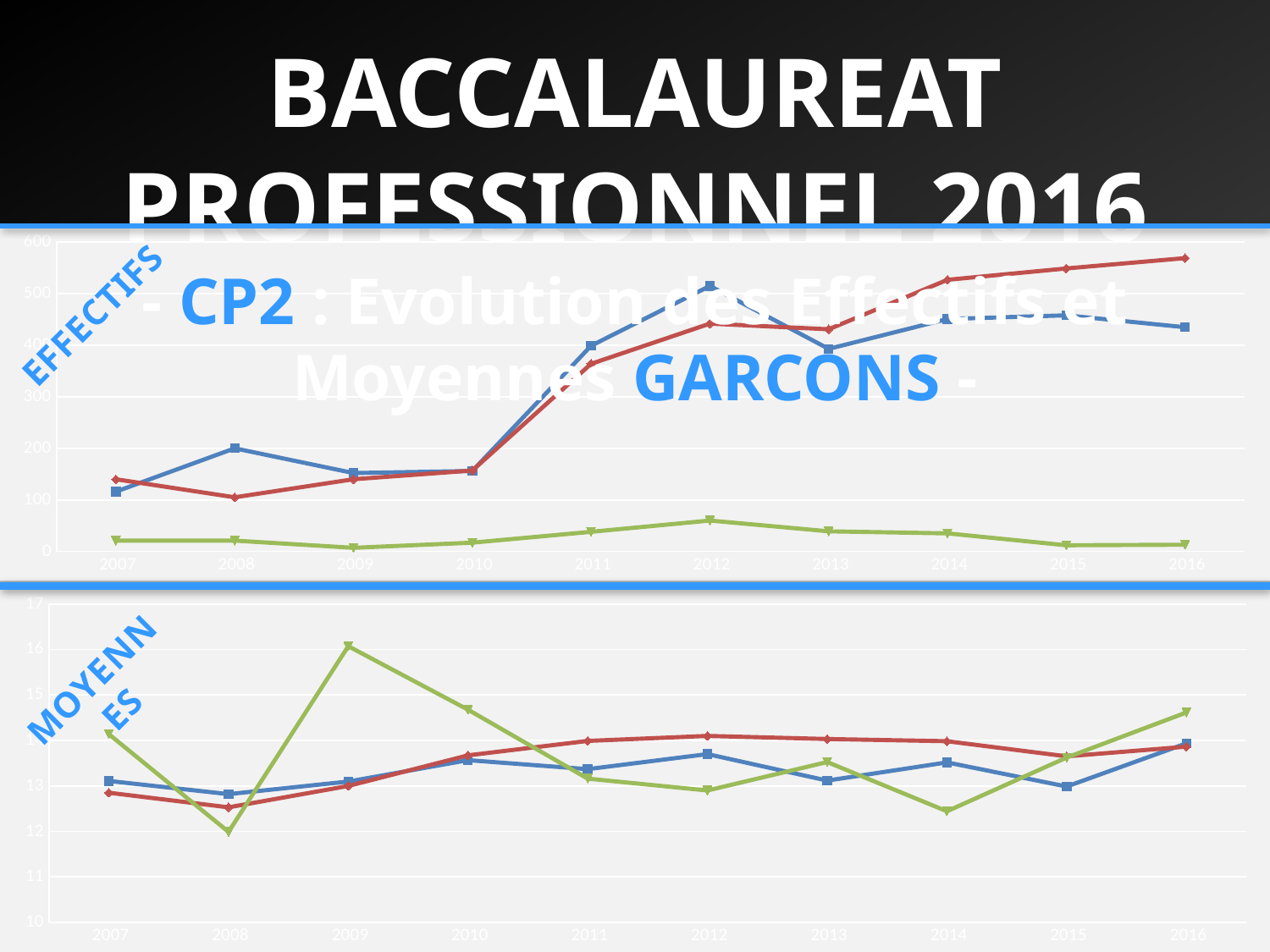
How many lines are plotted on the bottom chart (MOYENNES)? 3 In the bottom chart (MOYENNES), is the value of the green line in 2009 greater or less than 15? greater What kind of chart is the top chart (EFFECTIFS)? line chart In the top chart (EFFECTIFS), which line is higher in 2016, the red line or the blue line? the red line In the top chart (EFFECTIFS), is the value of the blue line in 2007 greater or less than 200? less How many years are shown on the x axis of the top chart (EFFECTIFS)? 10 In the top chart (EFFECTIFS), does the red line rise or fall from 2013 to 2016? rises In the top chart (EFFECTIFS), in which year does the green line reach its highest value? 2012 In the top chart (EFFECTIFS), is the value of the red line in 2016 greater or less than 500? greater In the bottom chart (MOYENNES), in which year does the green line reach its highest value? 2009 In the bottom chart (MOYENNES), in which year does the green line reach its lowest value? 2008